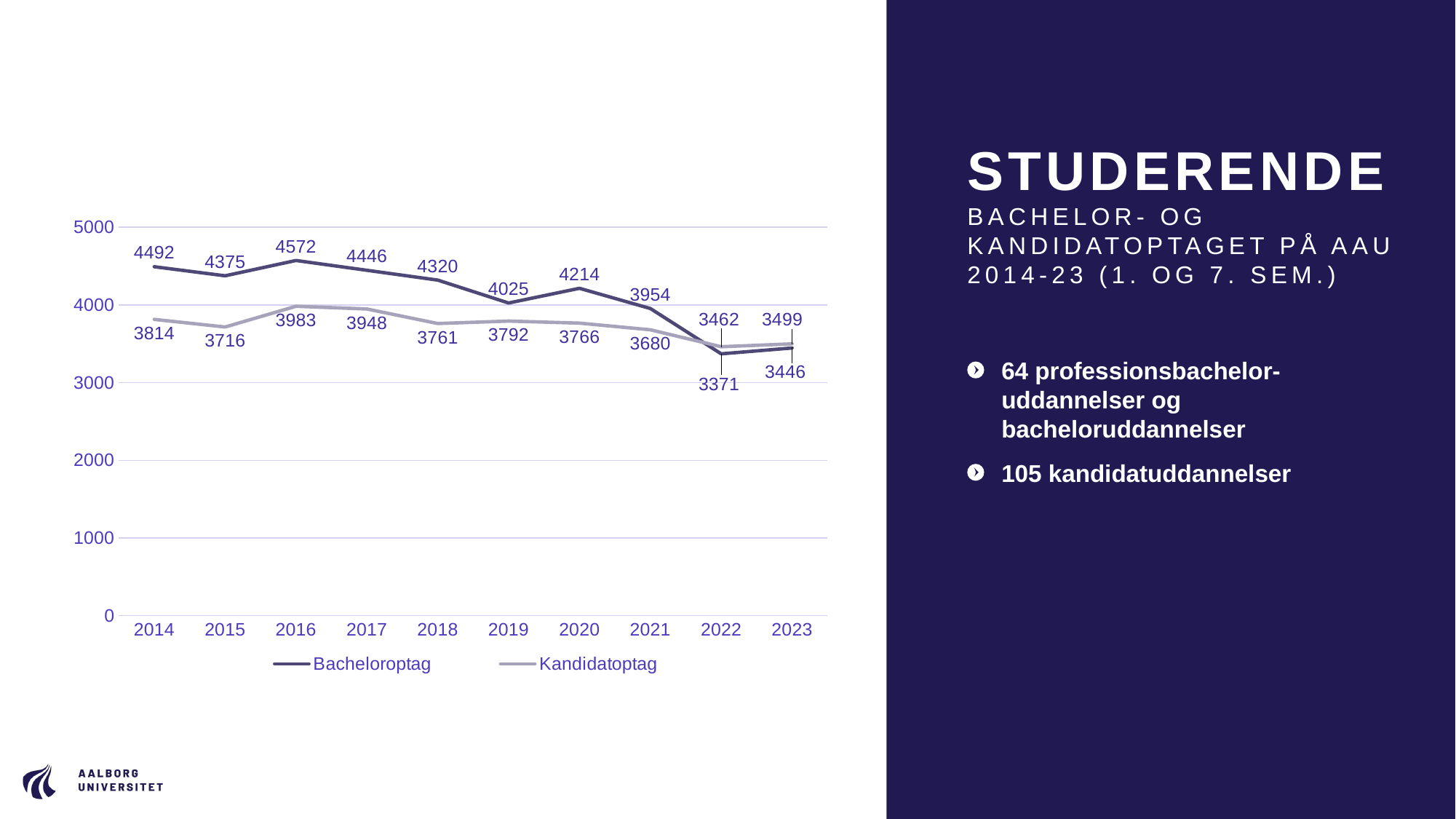
What is the Bacheloroptag value for 2016? 4572 In 2022, which series has the larger value, Bacheloroptag or Kandidatoptag? Kandidatoptag Does the Bacheloroptag series overall rise or fall from 2014 to 2023? Fall How many years are shown on the x axis? 10 What is the difference between the Bacheloroptag values for 2014 and 2023? 1046 In which year is Bacheloroptag highest? 2016 In which year is Bacheloroptag lowest? 2022 In which year is Kandidatoptag lowest? 2022 What is the Kandidatoptag value for 2019? 3792 What kind of chart is shown on the slide? Line chart In which year is Kandidatoptag highest? 2016 How many series does the legend list? 2